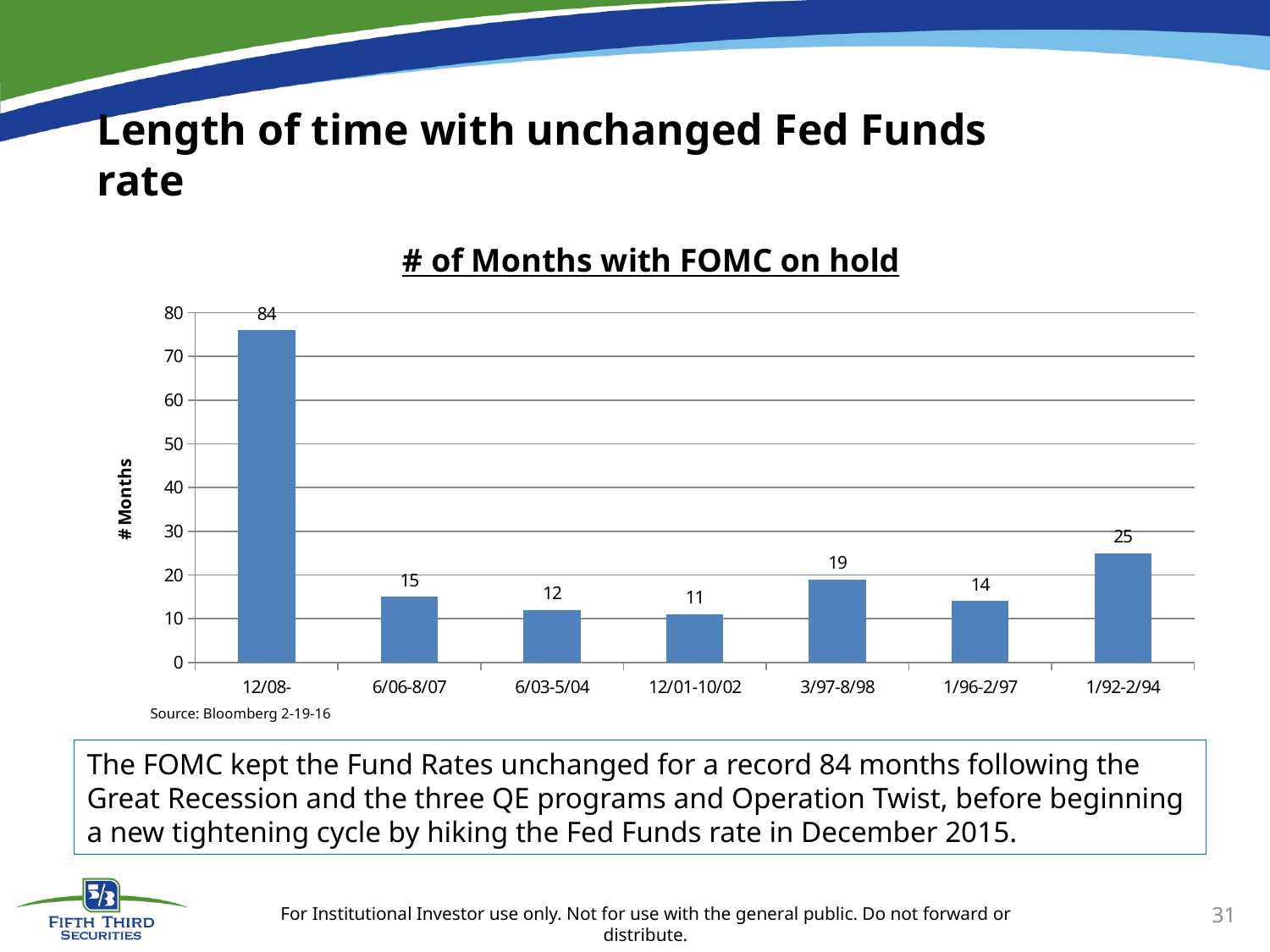
What is the label of the y axis? # Months What type of chart is shown on the slide? Bar chart Which period has the lowest number of months on hold? 12/01-10/02 Which period has more months on hold, 6/03-5/04 or 1/96-2/97? 1/96-2/97 Which period has the highest number of months on hold? 12/08- What is the difference in months between the 12/08- period and the 1/92-2/94 period? 59 What is the value for the 6/06-8/07 period? 15 How many periods are shown on the x axis? 7 What is the value shown for 3/97-8/98? 19 How many months was the FOMC on hold in the 12/08- period? 84 What is the title of the chart? # of Months with FOMC on hold How many months was the FOMC on hold during 1/92-2/94? 25